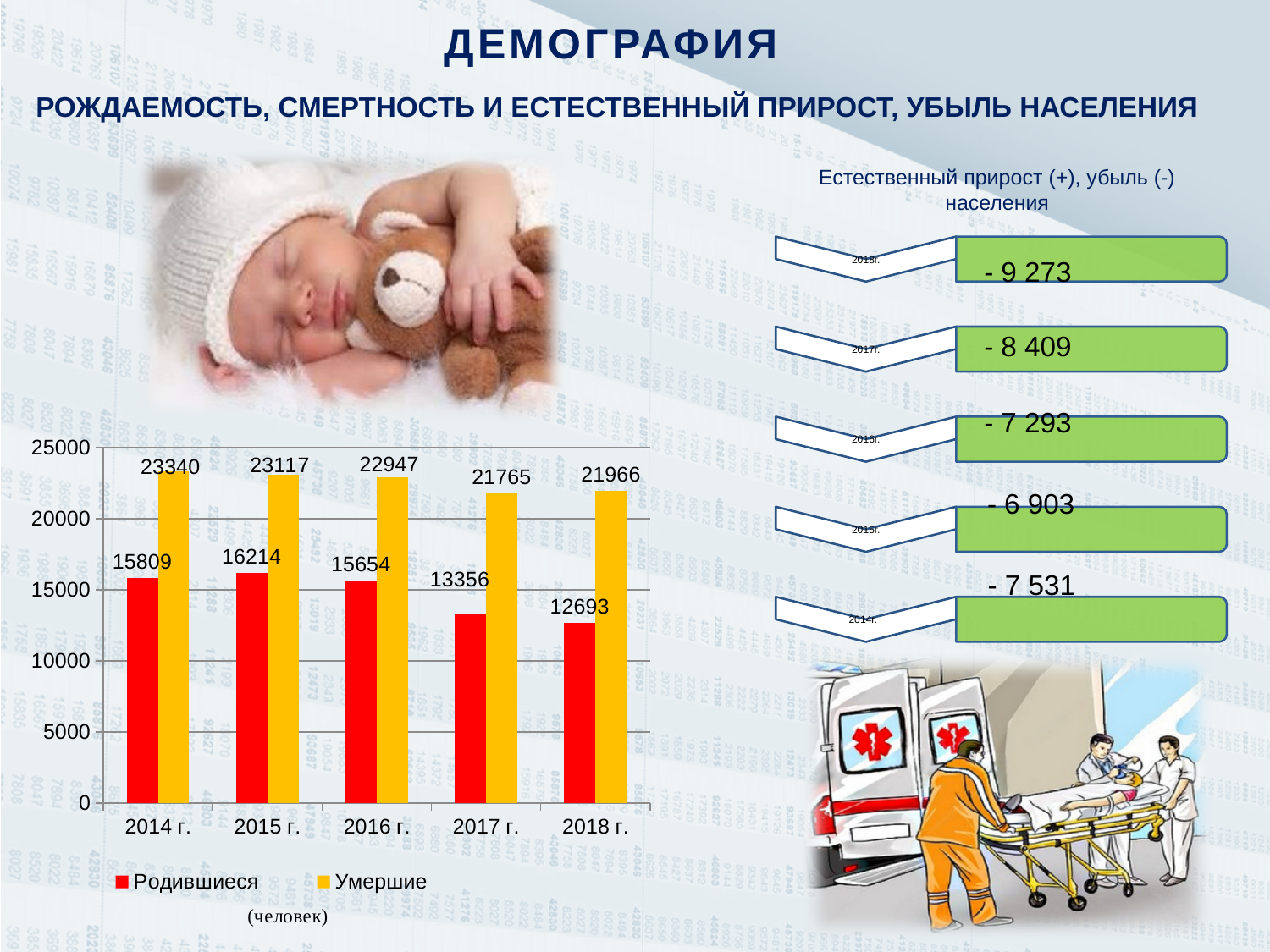
Does the value for Родившиеся generally rise or fall from 2015 г. to 2018 г.? fall What is the value for Умершие in 2017 г.? 21765 How many years are shown on the x axis of the bar chart? 5 What is the value for Родившиеся in 2018 г.? 12693 In which year is the value for Родившиеся the lowest? 2018 г. What is the value for Родившиеся in 2015 г.? 16214 How many series does the legend of the bar chart list? 2 Which colour represents the Умершие series in the bar chart? yellow What type of chart is shown on the slide? bar chart Which is larger in 2016 г., Родившиеся or Умершие? Умершие In which year is the value for Умершие the highest? 2014 г. What is the difference between Умершие and Родившиеся in 2014 г.? 7531